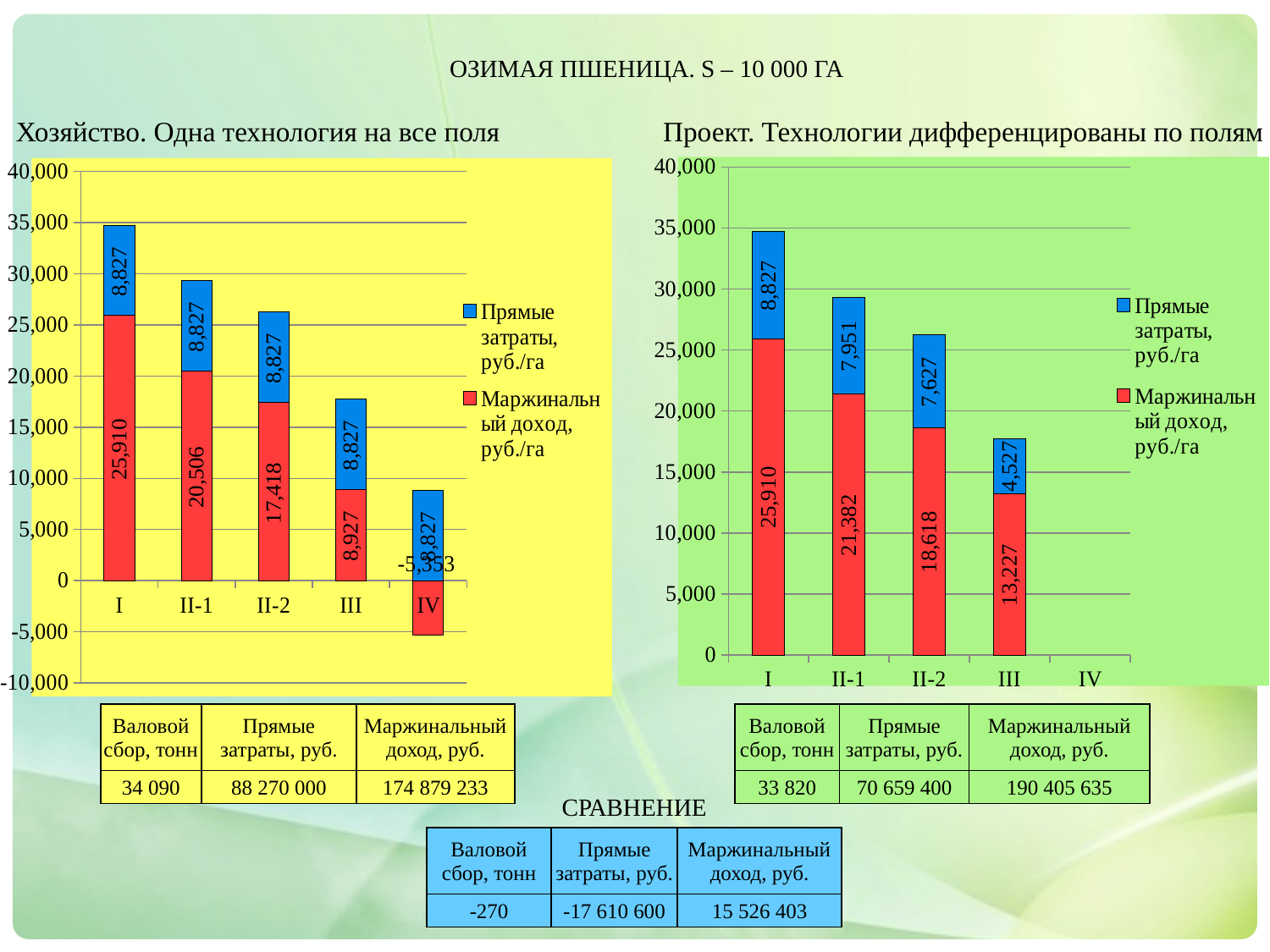
What type of chart is the left chart? Stacked bar chart In the left chart (Хозяйство. Одна технология на все поля), what is the Маржинальный доход value for category II-1? 20,506 In the left chart, what is the Маржинальный доход value for category IV? -5,353 In the right chart (Проект. Технологии дифференцированы по полям), what is the Прямые затраты value for category III? 4,527 In the left chart, what is the total of the stacked bar for category I? 34,737 In the right chart, do the Прямые затраты values rise or fall from category I to category III? Fall In the right chart, which is larger: the Маржинальный доход for II-2 or for III? II-2 In the right chart, which category has the highest Маржинальный доход? I In the right chart, what is the total height of the stacked bar for category II-1? 29,333 In the left chart, which category has the lowest Маржинальный доход? IV How many series does the legend of the right chart list? 2 In the left chart, what is the difference between the Маржинальный доход values for II-1 and II-2? 3,088